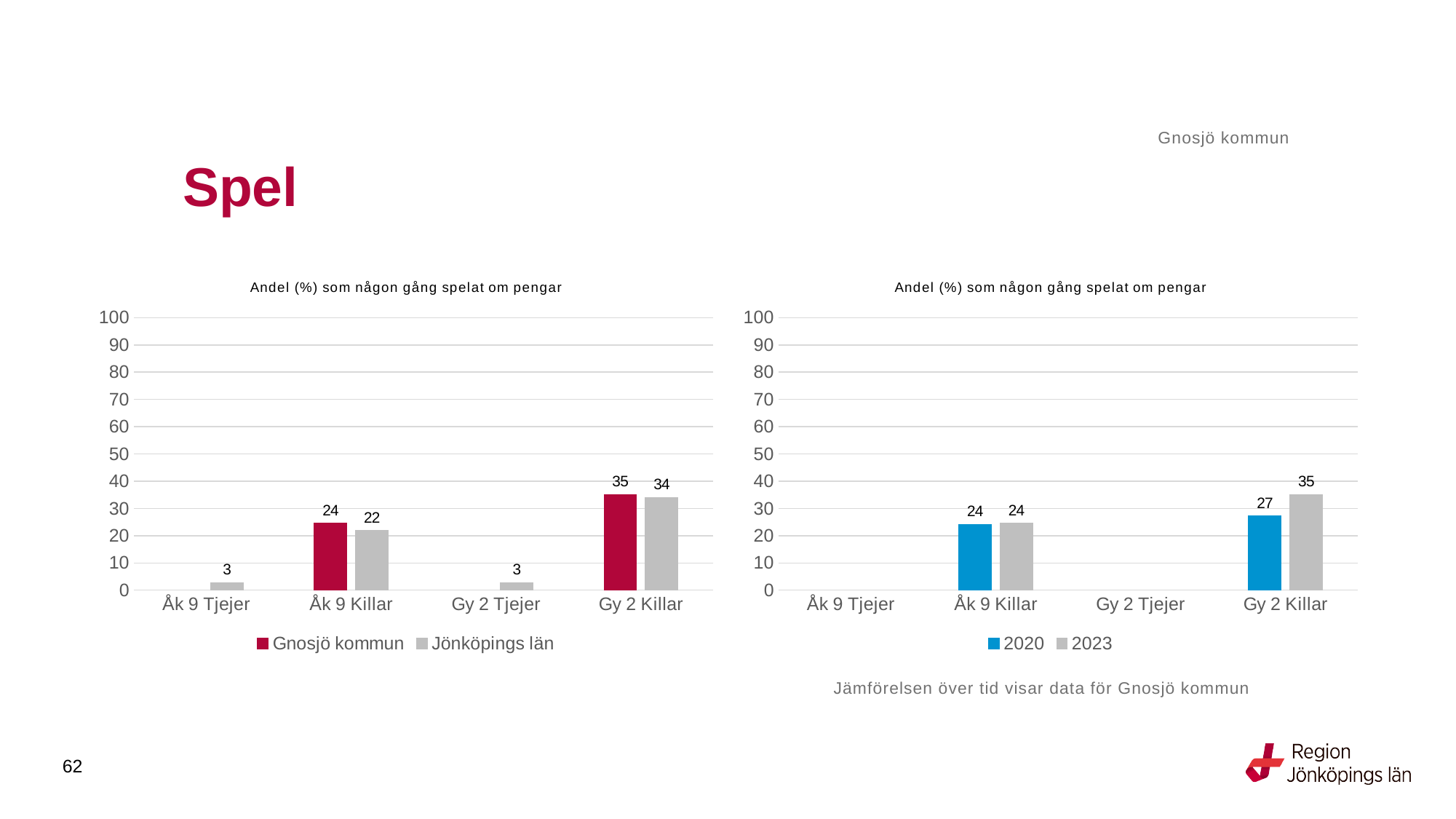
In the right chart, what is the value for 2020 for Gy 2 Killar? 27 How many categories are shown on the x axis of the left chart? 4 In the left chart, what is the difference between Gnosjö kommun and Jönköpings län for Åk 9 Killar? 2 In the right chart, what is the difference between 2023 and 2020 for Gy 2 Killar? 8 In the left chart, which category has the highest value for Jönköpings län? Gy 2 Killar In the left chart, how many series does the legend list? 2 In the left chart, what is the value for Jönköpings län for Åk 9 Killar? 22 In the left chart, what is the value for Gnosjö kommun for Gy 2 Killar? 35 In the right chart, which is larger for Gy 2 Killar, 2020 or 2023? 2023 In the left chart, what is the value for Jönköpings län for Gy 2 Tjejer? 3 In the right chart, what is the value for 2023 for Gy 2 Killar? 35 What kind of chart is the right chart? Bar chart